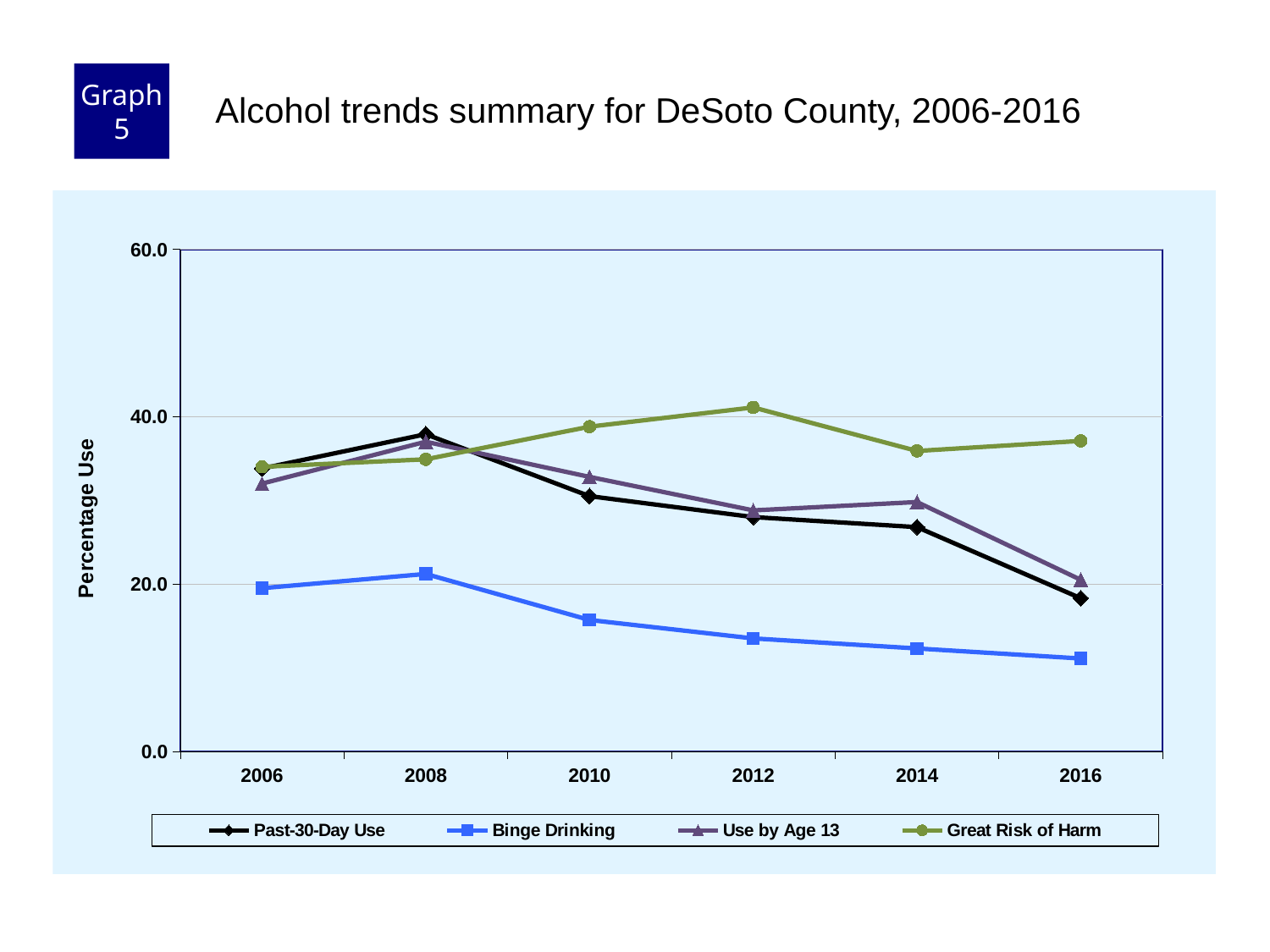
What kind of chart is shown on the slide? Line chart Does the Binge Drinking series rise or fall from 2008 to 2016? Fall Is the value for Great Risk of Harm in 2014 greater or less than 40.0? less Which series has the highest value in 2016? Great Risk of Harm How many series does the legend list? 4 What is the label on the y axis? Percentage Use Which is larger in 2012, Great Risk of Harm or Binge Drinking? Great Risk of Harm Is the value for Past-30-Day Use in 2008 greater or less than 40.0? less Which series has the lowest value in 2016? Binge Drinking Is the value for Binge Drinking in 2016 greater or less than 20.0? less What is the title of the chart? Alcohol trends summary for DeSoto County, 2006-2016 How many years are plotted along the x axis? 6